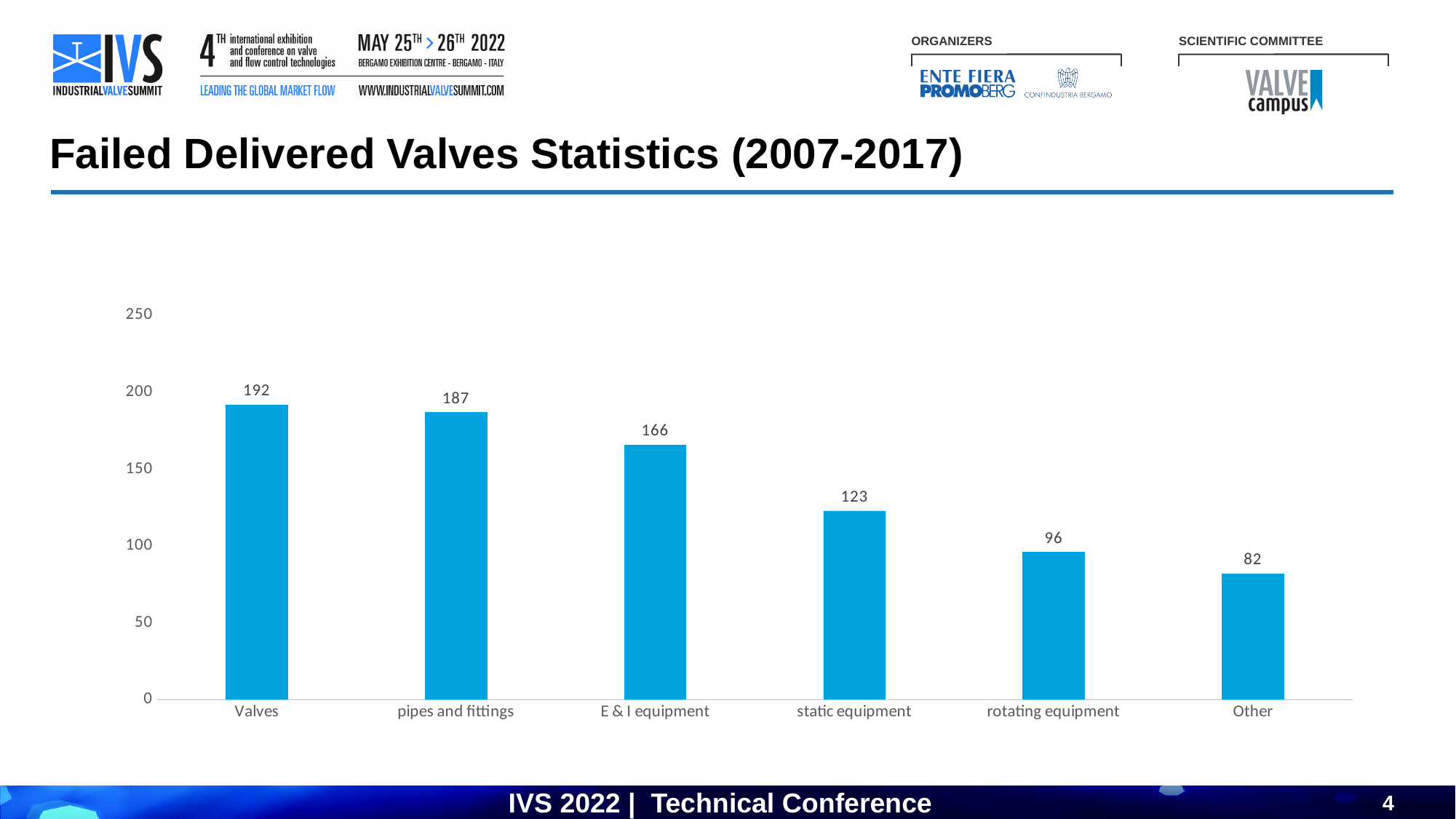
Which is larger, the value for E & I equipment or the value for static equipment? E & I equipment What is the value for rotating equipment? 96 What is the value for E & I equipment? 166 What is the value for pipes and fittings? 187 How many categories are shown on the x axis? 6 What is the difference between the values for Valves and Other? 110 Which category has the highest value? Valves What is the value for static equipment? 123 What kind of chart is shown on the slide? bar chart What is the value for Valves? 192 Is the value for rotating equipment greater or less than 100? less Which category has the lowest value? Other